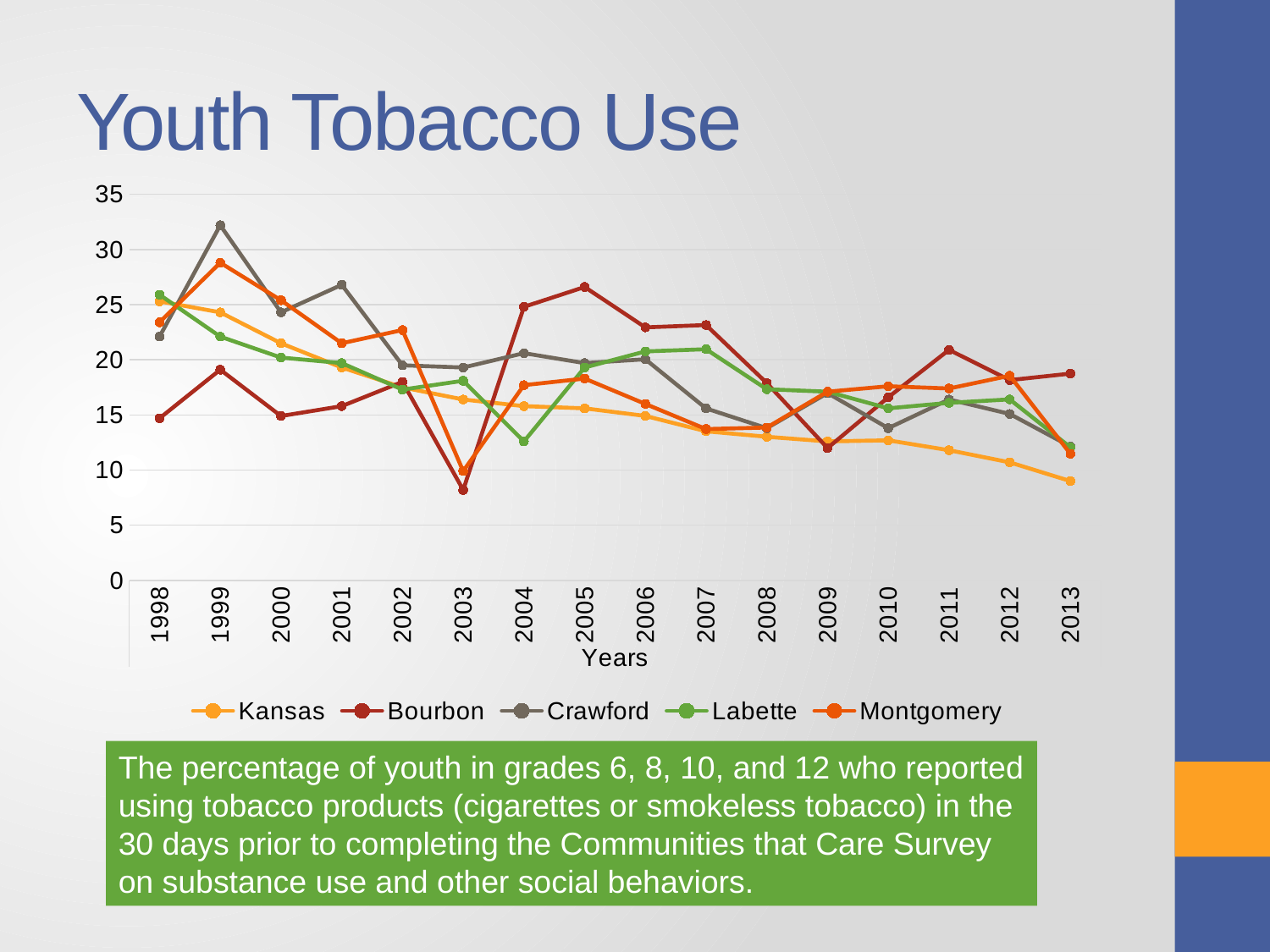
Is the value for Montgomery in 1999 greater or less than 25? greater In 2003, which is larger, the value for Labette or the value for Bourbon? Labette How many years are shown along the x axis? 16 Is the value for Crawford in 1999 greater or less than 30? greater What kind of chart is shown on the slide? line chart Is the value for Bourbon in 2003 greater or less than 10? less Which series has the highest value in 2013? Bourbon How many series does the legend list? 5 Does the Kansas line generally rise or fall from 1998 to 2013? fall Which series has the lowest value in 2013? Kansas What is the title of the x axis? Years